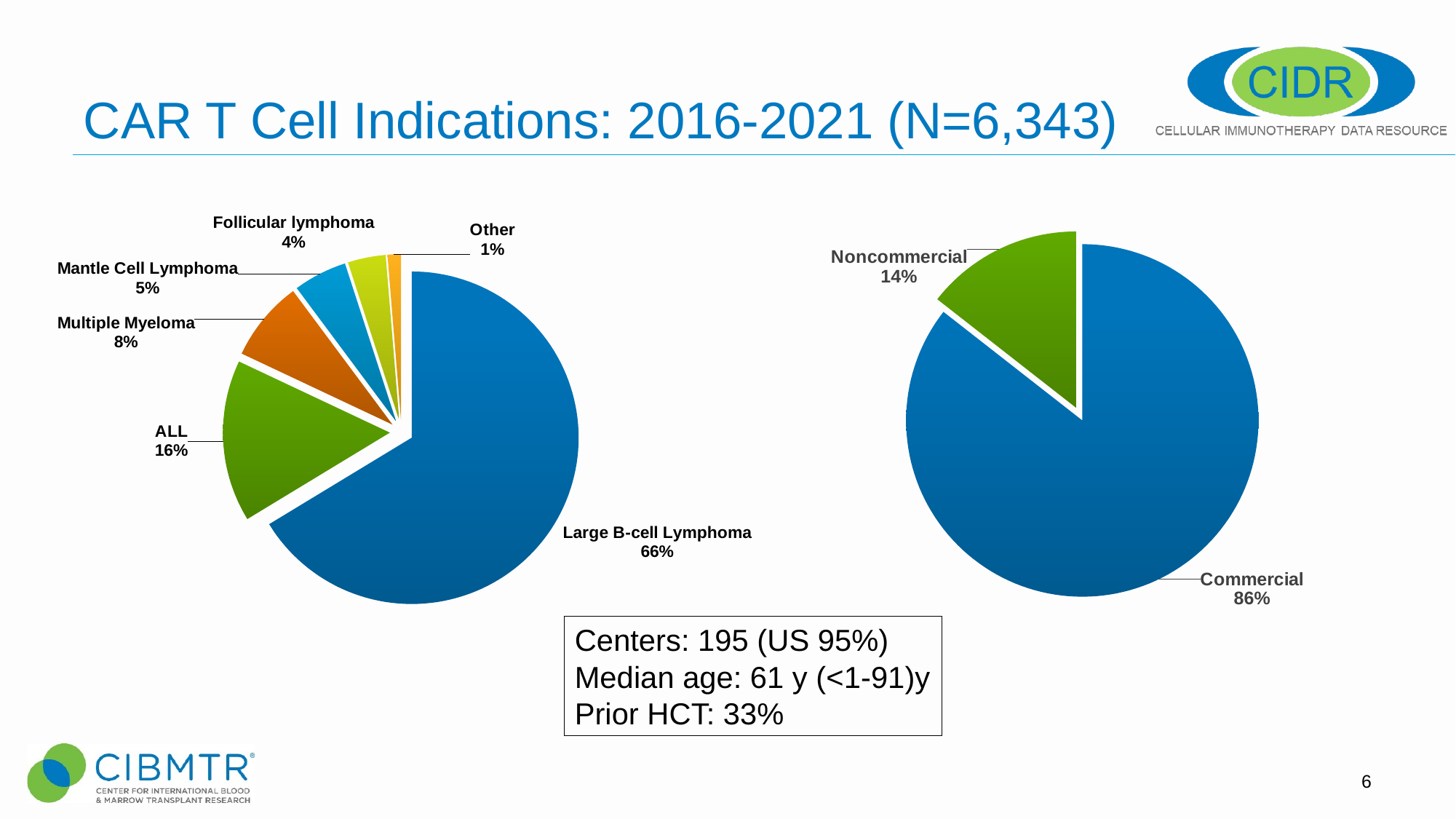
In the left pie chart, how many categories are shown? 6 In the left pie chart, what share does ALL have? 16% In the left pie chart, what share does Large B-cell Lymphoma have? 66% In the left pie chart, which is larger, Follicular lymphoma or Mantle Cell Lymphoma? Mantle Cell Lymphoma In the left pie chart, what share does Mantle Cell Lymphoma have? 5% In the left pie chart, which category has the smallest slice? Other In the right pie chart, what is the difference between the Commercial and Noncommercial shares? 72% In the left pie chart, what is the difference between the shares of ALL and Multiple Myeloma? 8% What kind of chart is the chart on the right of the slide? Pie chart In the left pie chart, which category has the largest slice? Large B-cell Lymphoma